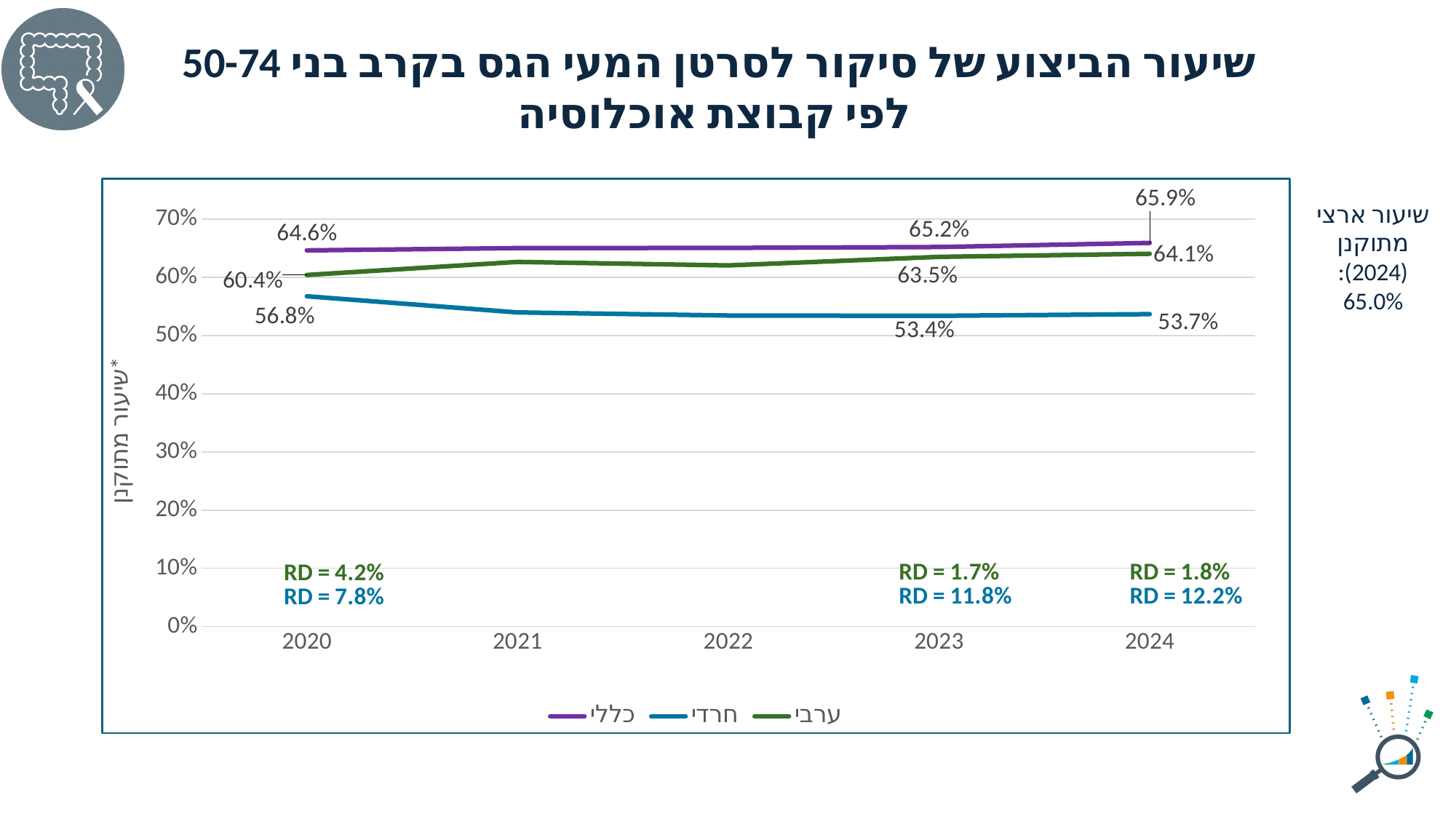
What is the value for the ערבי series in 2023? 63.5% Is the value for the חרדי series in 2022 greater or less than 60%? less What type of chart is shown on the slide? line chart What is the value for the כללי series in 2024? 65.9% How many years are shown on the x axis? 5 What is the difference between the כללי and חרדי values in 2024? 12.2% How many series does the legend list? 3 What is the value for the חרדי series in 2020? 56.8% Which is larger in 2023: the ערבי value or the חרדי value? ערבי Does the ערבי series rise or fall from 2020 to 2024? rise Which series has the highest value in 2020? כללי Which series has the lowest value in 2024? חרדי